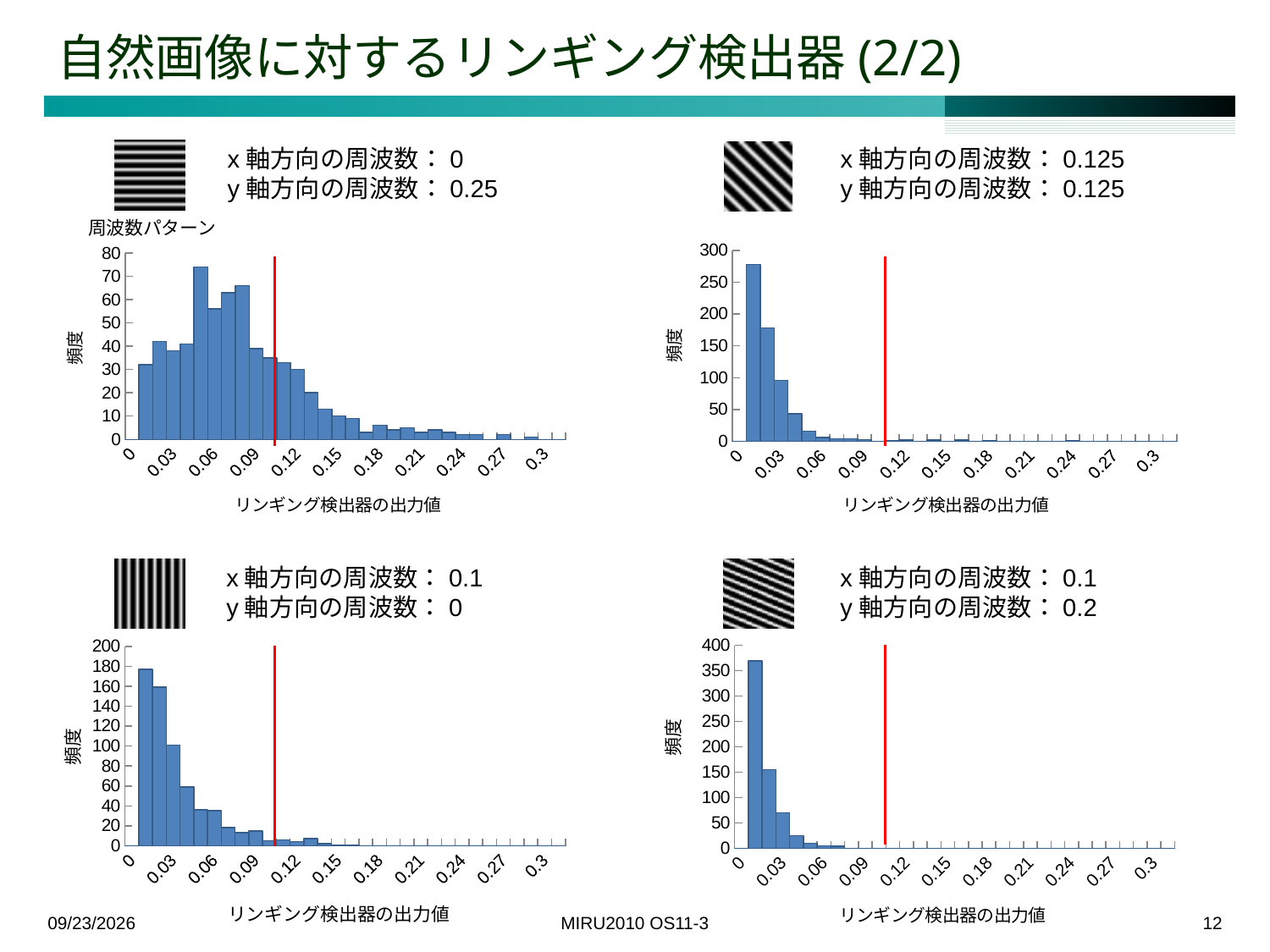
In the bottom-left chart, is the second bar (around 0.02) greater or less than 140? greater In the top-left chart, is the value of the tallest bar greater or less than 70? greater In the top-right chart, is the value of the tallest bar greater or less than 250? greater What is the highest value shown on the y-axis of the bottom-right chart? 400 What kind of chart is the top-left chart on the slide? bar chart What is the x-axis label of the top-left chart? リンギング検出器の出力値 In the top-right chart, do the bar heights rise or fall as the x-axis value increases? fall In the bottom-right chart, do the bar heights rise or fall as the x-axis value increases? fall